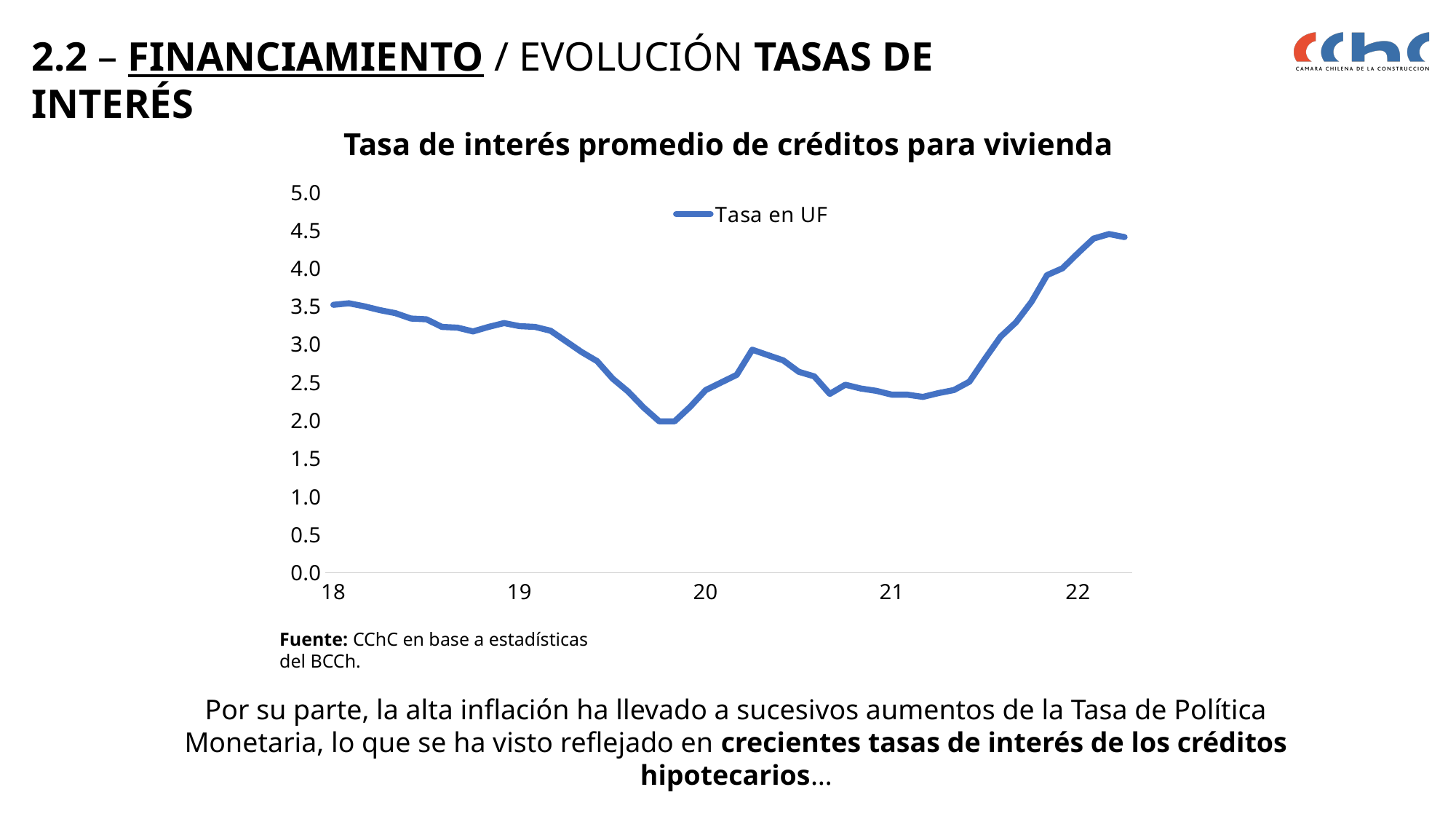
Is the highest point of the Tasa en UF line greater or less than 4.0? greater What is the name of the series shown in the legend? Tasa en UF Does the Tasa en UF line rise or fall between 18 and 19? fall Is the value for Tasa en UF at 21 greater or less than 3.0? less Is the value for Tasa en UF at the start of 18 greater or less than 3.0? greater What type of chart is shown on the slide? line chart Does the Tasa en UF line rise or fall between 21 and 22? rise What is the title of the chart? Tasa de interés promedio de créditos para vivienda How many year labels are shown on the x axis? 5 How many series does the legend list? 1